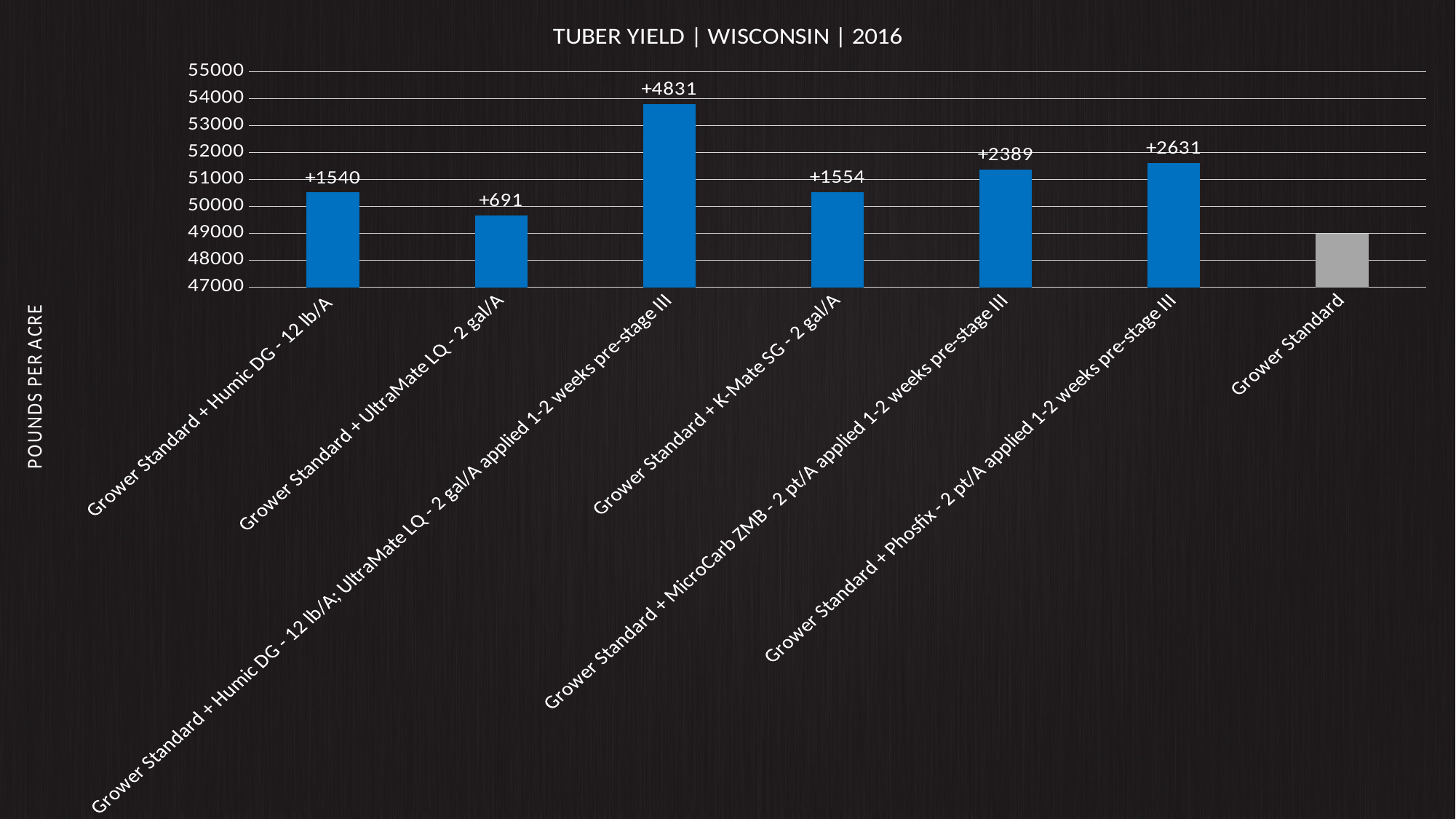
Which category has the shortest bar in the chart? Grower Standard Which has the larger labelled gain: Grower Standard + MicroCarb ZMB - 2 pt/A or Grower Standard + Phosfix - 2 pt/A? Grower Standard + Phosfix - 2 pt/A Is the value for Grower Standard + UltraMate LQ - 2 gal/A greater or less than 50000? less What is the difference between the labelled gains for Grower Standard + Phosfix - 2 pt/A and Grower Standard + MicroCarb ZMB - 2 pt/A? 242 Which treatment has the tallest bar in the chart? Grower Standard + Humic DG - 12 lb/A; UltraMate LQ - 2 gal/A applied 1-2 weeks pre-stage III What kind of chart is shown on the slide? bar chart How many bars are plotted in the chart? 7 What data label is printed above the bar for Grower Standard + Phosfix - 2 pt/A applied 1-2 weeks pre-stage III? +2631 What data label is printed above the bar for Grower Standard + Humic DG - 12 lb/A? +1540 What is the label on the vertical axis? POUNDS PER ACRE What is the title of the chart? TUBER YIELD | WISCONSIN | 2016 What data label is printed above the bar for Grower Standard + UltraMate LQ - 2 gal/A? +691